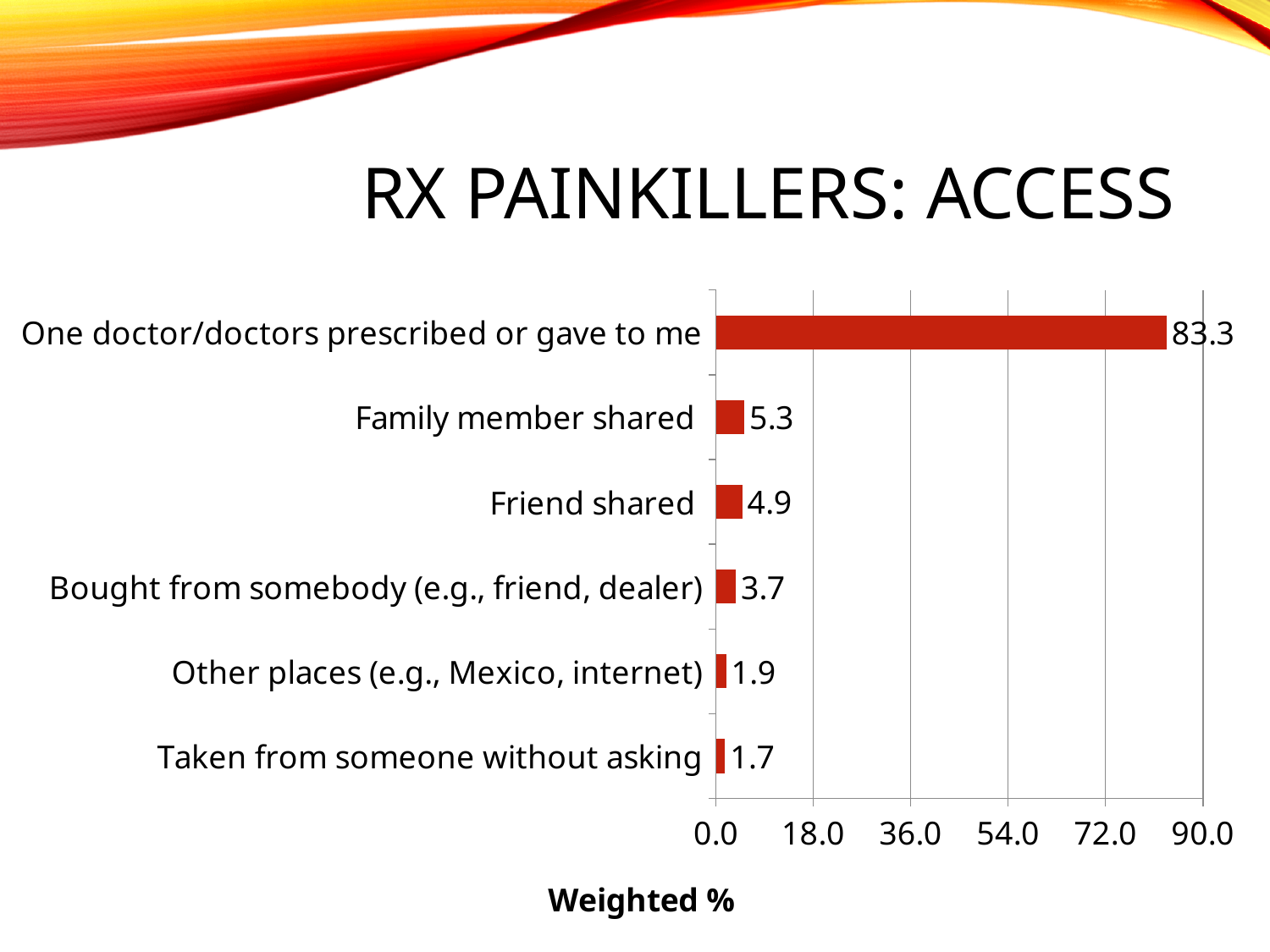
Which access source has the lowest weighted %? Taken from someone without asking What is the weighted % for "Friend shared"? 4.9 What is the label of the horizontal axis? Weighted % What is the weighted % for "Taken from someone without asking"? 1.7 Which is larger: the weighted % for "Bought from somebody (e.g., friend, dealer)" or for "Other places (e.g., Mexico, internet)"? Bought from somebody (e.g., friend, dealer) What kind of chart is shown on the slide? Bar chart What is the difference in weighted % between "One doctor/doctors prescribed or gave to me" and "Bought from somebody (e.g., friend, dealer)"? 79.6 What is the weighted % for "One doctor/doctors prescribed or gave to me"? 83.3 What is the difference in weighted % between "Family member shared" and "Friend shared"? 0.4 What is the weighted % for "Family member shared"? 5.3 Which access source has the highest weighted %? One doctor/doctors prescribed or gave to me How many access sources are shown in the chart? 6